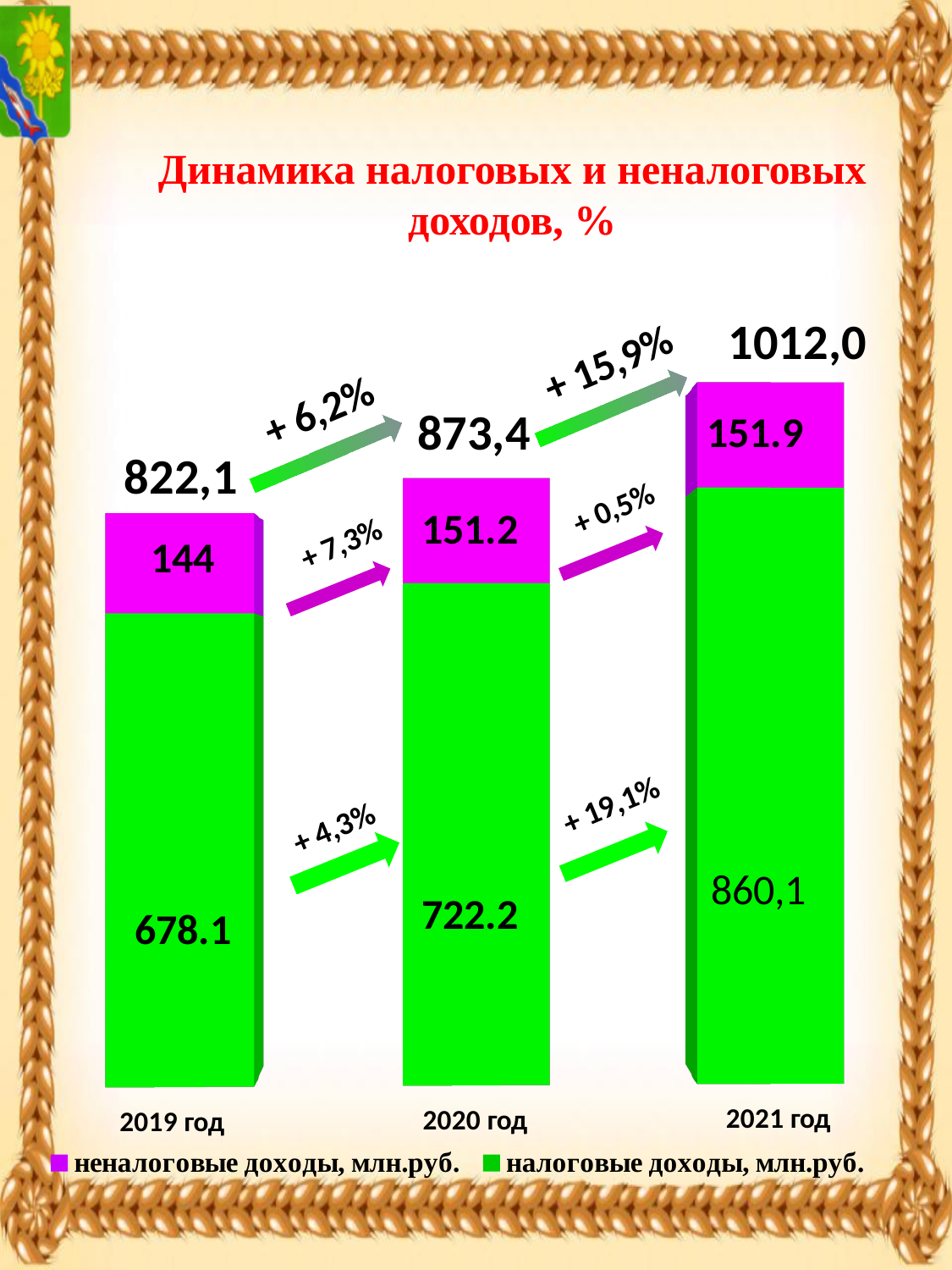
How many series does the legend list? 2 How many years (categories) are shown on the chart? 3 What is the difference between налоговые доходы in 2020 год and 2019 год? 44.1 Which is larger: неналоговые доходы in 2021 год or in 2020 год? 2021 год What is the value of налоговые доходы for 2019 год? 678.1 Which year has the highest value of налоговые доходы? 2021 год Which year has the lowest value of неналоговые доходы? 2019 год What is the total shown above the bar for 2019 год? 822,1 What is the total shown above the bar for 2021 год? 1012,0 What type of chart is shown on the slide? stacked bar chart What is the value of неналоговые доходы for 2020 год? 151.2 What is the value of налоговые доходы for 2021 год? 860,1